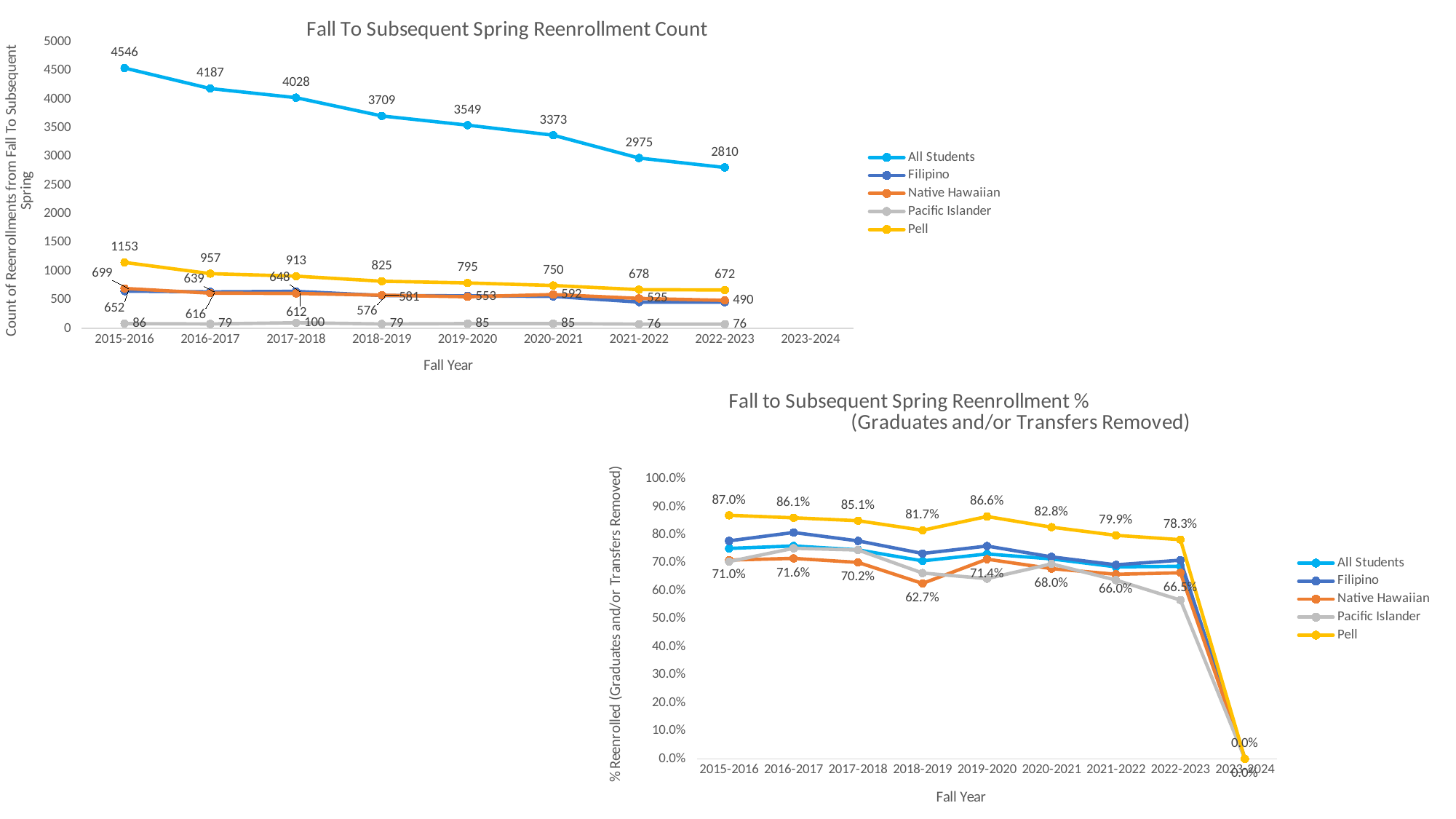
In the 'Fall To Subsequent Spring Reenrollment Count' chart, in which year is the Pacific Islander count highest? 2017-2018 In the 'Fall to Subsequent Spring Reenrollment %' chart, which is larger in 2018-2019: Pell or All Students? Pell In the 'Fall To Subsequent Spring Reenrollment Count' chart, what is the value for All Students in 2015-2016? 4546 In the 'Fall To Subsequent Spring Reenrollment Count' chart, by how much did the All Students count fall from 2015-2016 to 2022-2023? 1736 What kind of chart is the 'Fall To Subsequent Spring Reenrollment Count' chart? Line chart In the 'Fall to Subsequent Spring Reenrollment %' chart, is the value for All Students in 2015-2016 greater or less than 70.0%? greater In the 'Fall To Subsequent Spring Reenrollment Count' chart, what is the value for Pell in 2015-2016? 1153 In the 'Fall To Subsequent Spring Reenrollment Count' chart, does the All Students line rise or fall from 2015-2016 to 2022-2023? Fall In the 'Fall to Subsequent Spring Reenrollment %' chart, what is the value for Pell in 2015-2016? 87.0% In the 'Fall To Subsequent Spring Reenrollment Count' chart, what is the value for All Students in 2022-2023? 2810 How many series does the legend of the 'Fall To Subsequent Spring Reenrollment Count' chart list? 5 In the 'Fall to Subsequent Spring Reenrollment %' chart, what is the value for Pell in 2022-2023? 78.3%